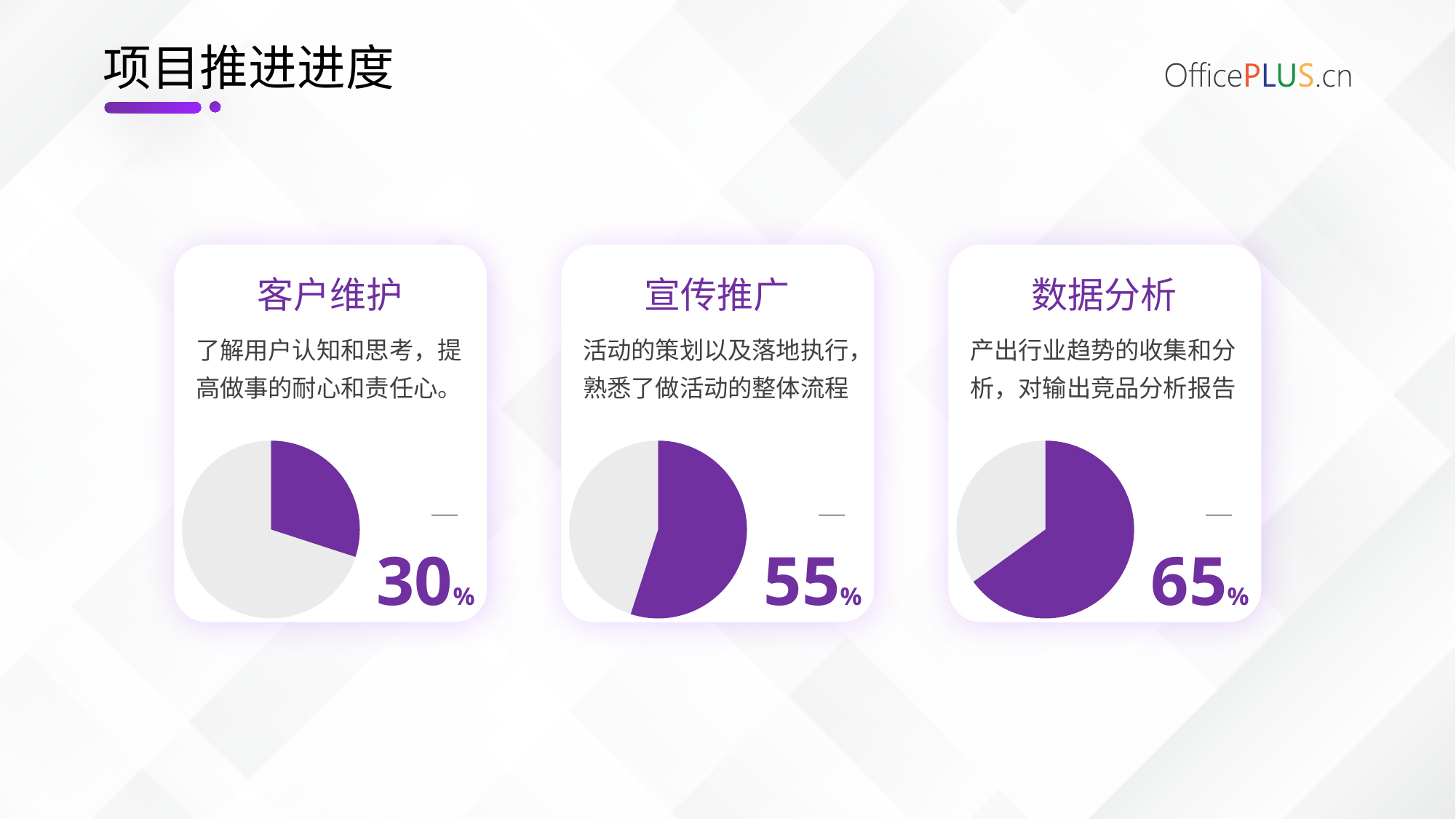
What colour is the slice representing the completed progress in each pie chart? Purple What percentage is shown for the 数据分析 pie chart? 65% What percentage is shown for the 宣传推广 pie chart? 55% In the 宣传推广 pie chart, what share of the pie does the purple slice represent? 55% Which shows a larger percentage, the 宣传推广 chart or the 数据分析 chart? 数据分析 Which of the three pie charts shows the highest percentage? 数据分析 What is the difference in percentage points between the 宣传推广 chart and the 客户维护 chart? 25 What is the difference in percentage points between the 数据分析 chart and the 客户维护 chart? 35 How many pie charts are on the slide? 3 What percentage is shown for the 客户维护 pie chart? 30% What kind of chart is used in each of the three cards on the slide? Pie chart Which of the three pie charts shows the lowest percentage? 客户维护